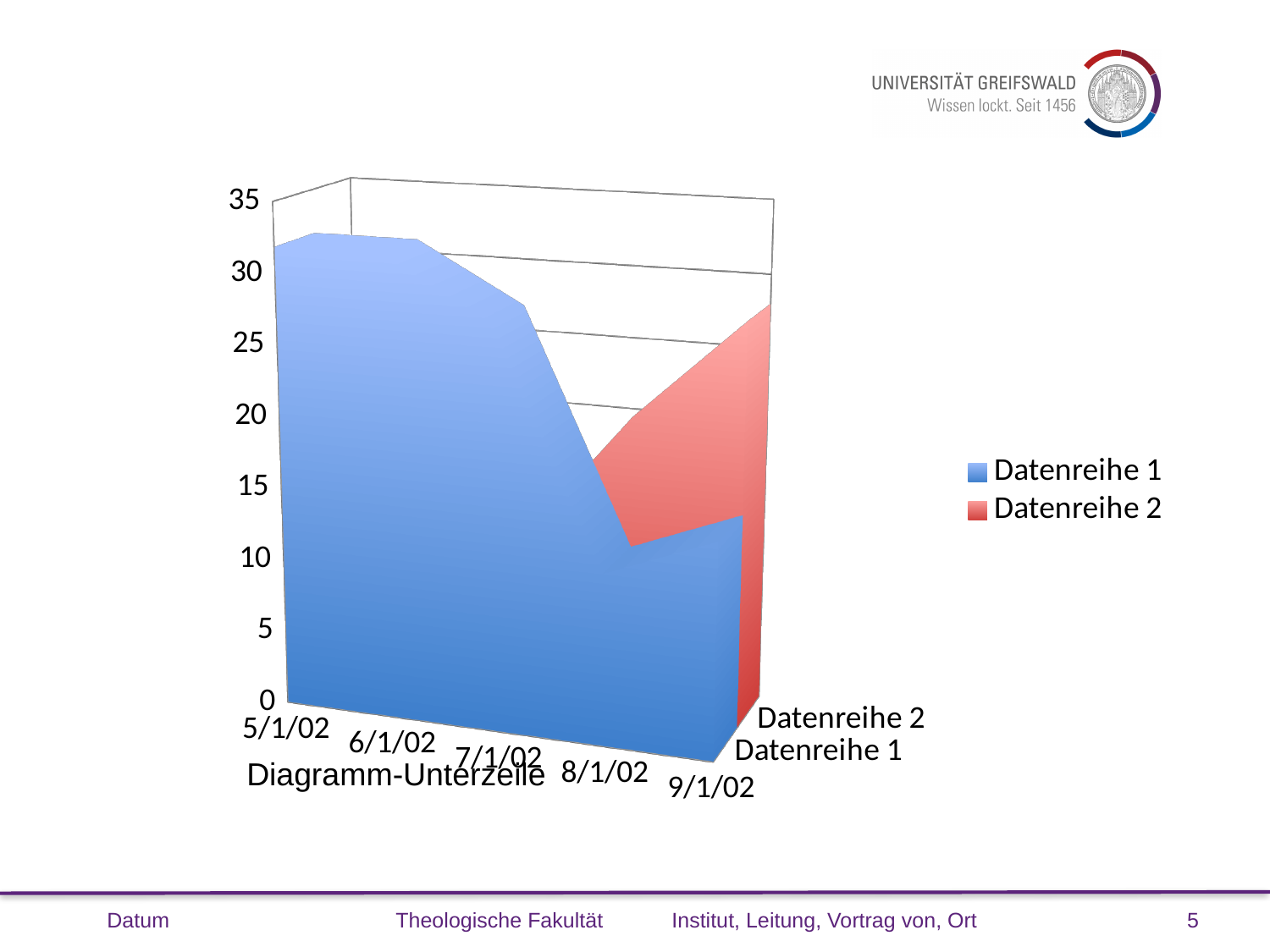
At 9/1/02, which series has the larger value, Datenreihe 1 or Datenreihe 2? Datenreihe 2 Does Datenreihe 1 rise or fall from 5/1/02 to 8/1/02? fall Which series are listed in the legend? Datenreihe 1 and Datenreihe 2 How many series does the legend list? 2 Is the value of Datenreihe 1 at 5/1/02 greater or less than 25? greater Is the value of Datenreihe 1 at 8/1/02 greater or less than 20? less Is the value of Datenreihe 1 at 7/1/02 greater or less than 20? greater What text appears as the axis title below the x axis? Diagramm-Unterzeile Which is larger for Datenreihe 1: the value at 5/1/02 or the value at 8/1/02? 5/1/02 What is the highest value shown on the vertical axis? 35 What kind of chart is shown on the slide? area chart How many dates are shown along the x axis? 5